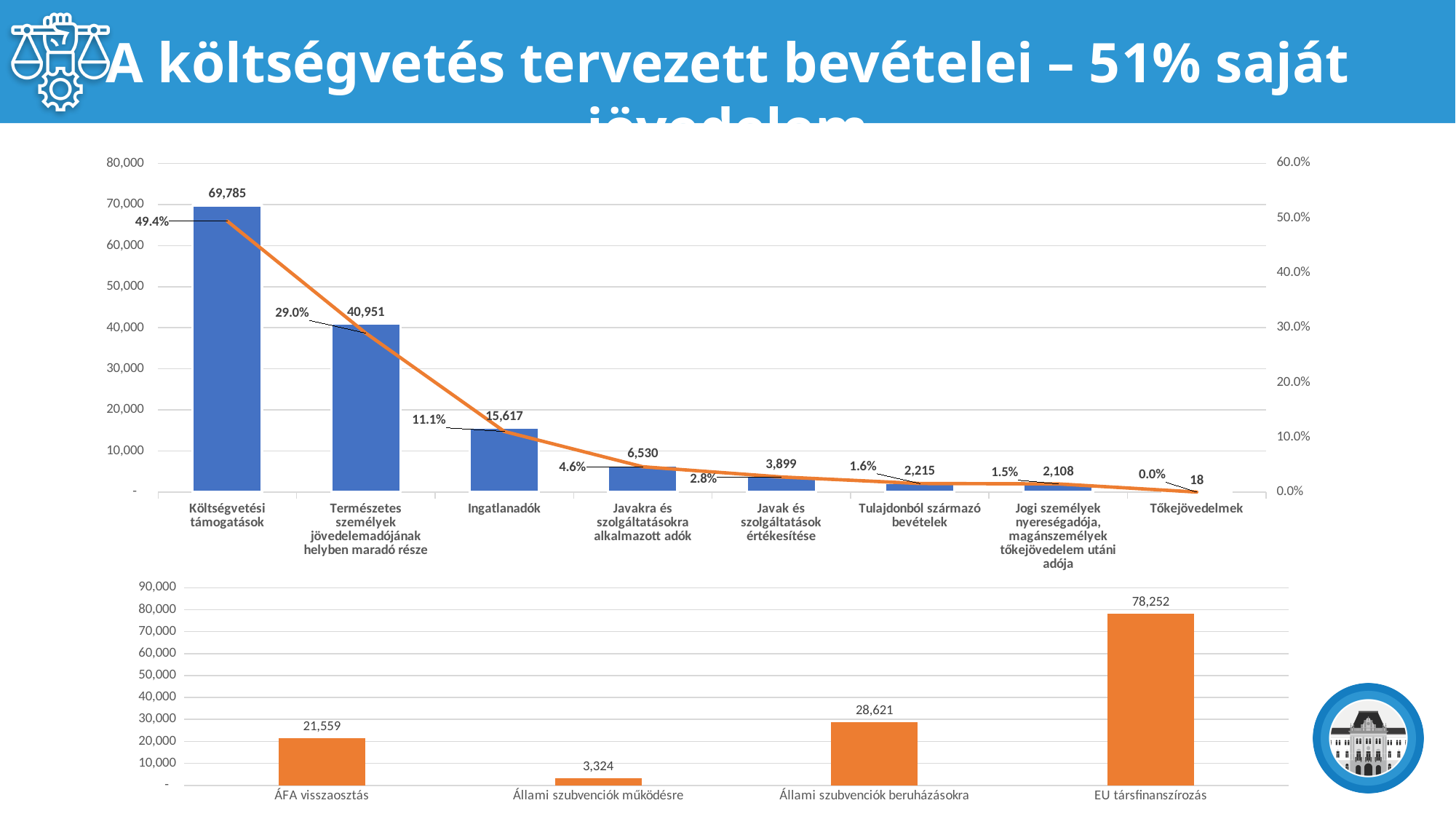
In the top chart, what is the value for Ingatlanadók? 15,617 In the bottom chart, which category has the lowest value? Állami szubvenciók működésre In the top chart, which category has the lowest value? Tőkejövedelmek In the top chart, how many categories are shown on the x axis? 8 In the top chart, what is the difference between the values for Költségvetési támogatások and Természetes személyek jövedelemadójának helyben maradó része? 28,834 In the bottom chart, what is the value for EU társfinanszírozás? 78,252 In the top chart, do the bar values rise or fall from left to right along the x axis? fall In the bottom chart, what is the difference between Állami szubvenciók beruházásokra and ÁFA visszaosztás? 7,062 In the top chart, which category has the highest bar? Költségvetési támogatások In the top chart, what percentage is shown for Természetes személyek jövedelemadójának helyben maradó része? 29.0% In the bottom chart, which is larger: ÁFA visszaosztás or Állami szubvenciók beruházásokra? Állami szubvenciók beruházásokra What kind of chart is the bottom chart? bar chart